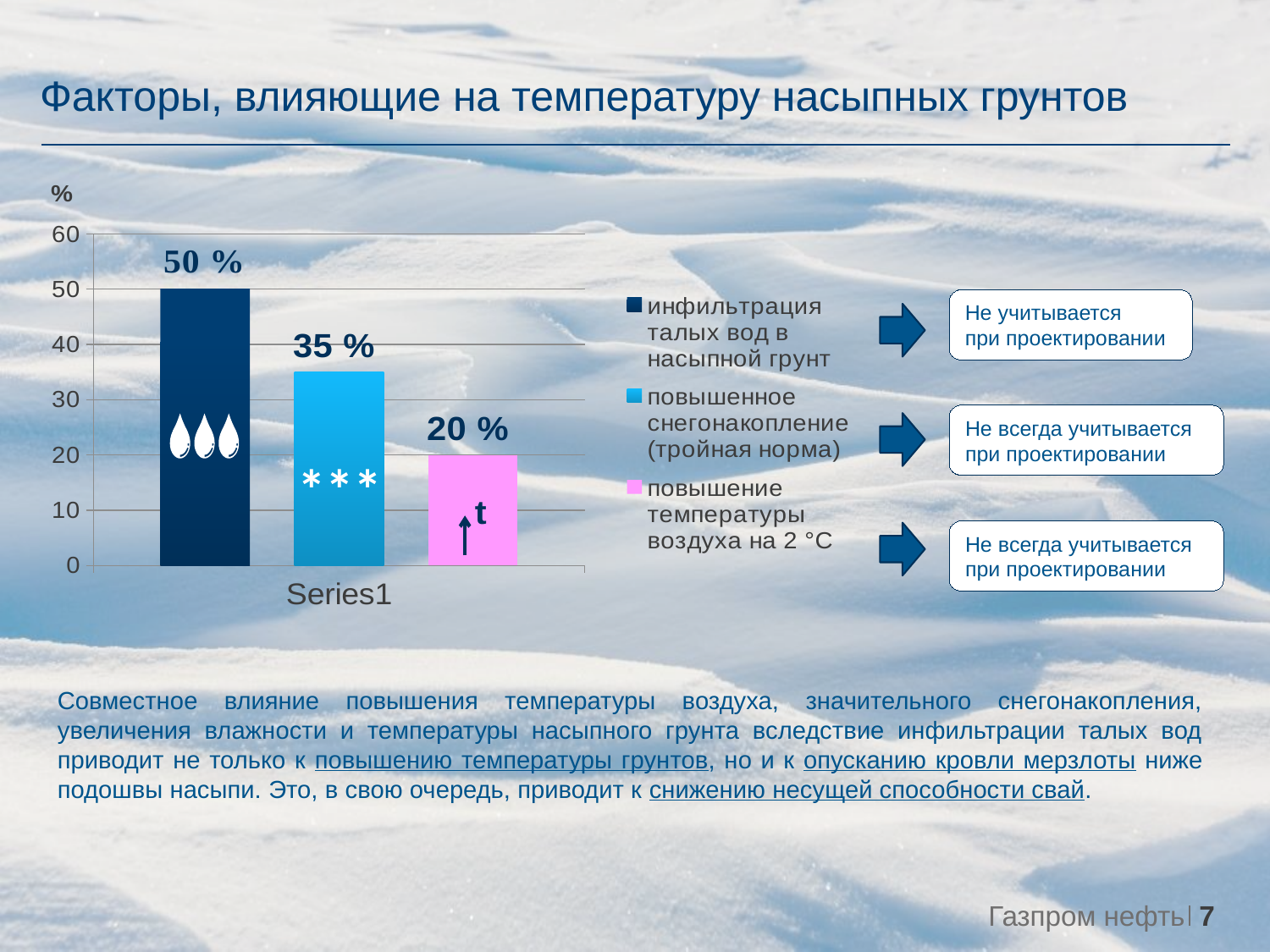
What is the difference between the value for "инфильтрация талых вод в насыпной грунт" and the value for "повышенное снегонакопление (тройная норма)"? 15 % Which series has the highest value? инфильтрация талых вод в насыпной грунт What value is shown for the series "повышенное снегонакопление (тройная норма)"? 35 % Is the value for "повышенное снегонакопление (тройная норма)" greater or less than 40? less Which series has the lowest value? повышение температуры воздуха на 2 °C What is the label on the category axis of the chart? Series1 Which is larger: the value for "повышенное снегонакопление (тройная норма)" or the value for "повышение температуры воздуха на 2 °C"? повышенное снегонакопление (тройная норма) What value is shown for the series "повышение температуры воздуха на 2 °C"? 20 % How many series does the legend list? 3 What value is shown for the series "инфильтрация талых вод в насыпной грунт"? 50 % What is the difference between the value for "повышенное снегонакопление (тройная норма)" and the value for "повышение температуры воздуха на 2 °C"? 15 % What kind of chart is shown on the slide? bar chart